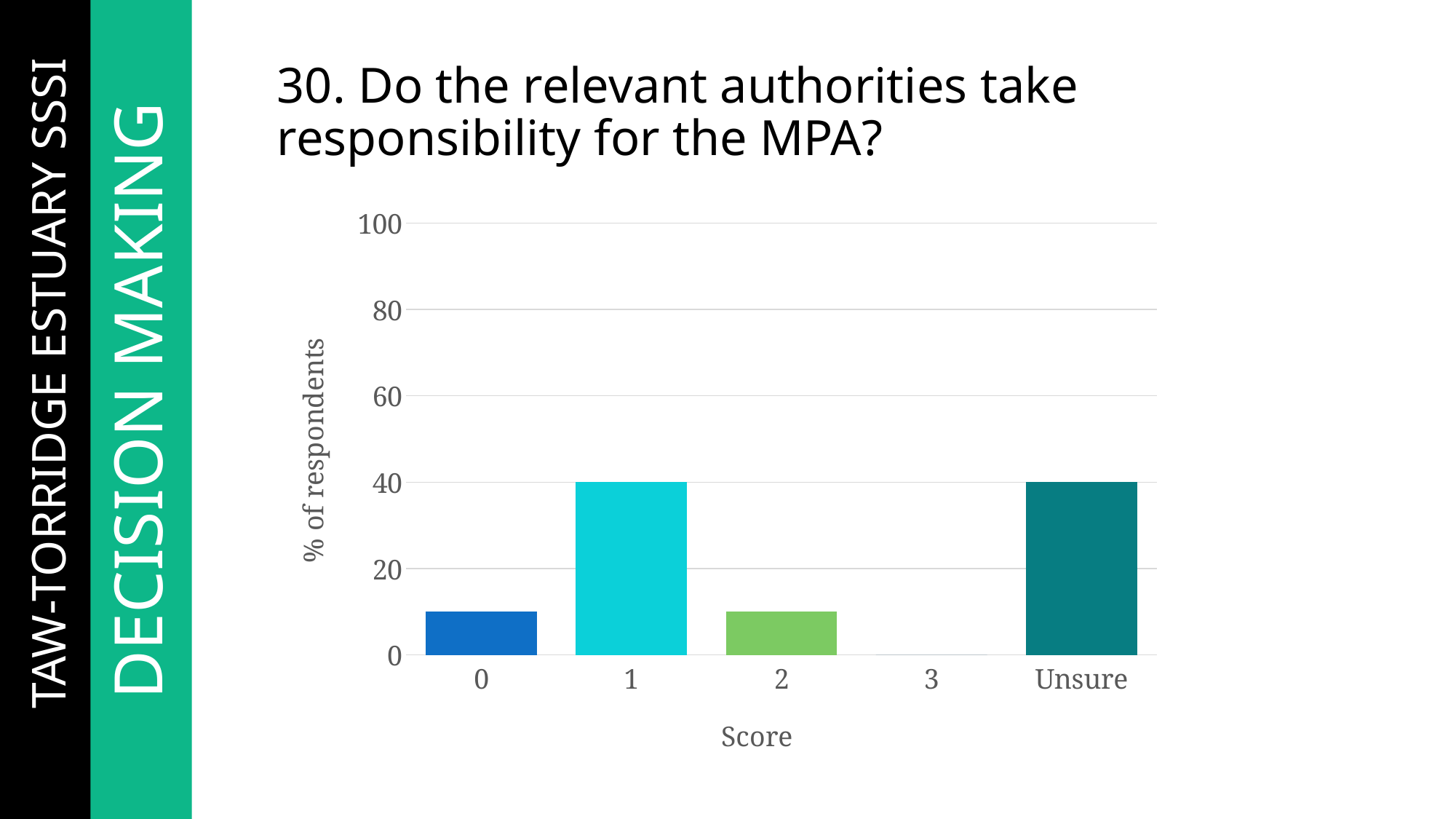
What is the label of the y axis? % of respondents What is the difference in % of respondents between score 1 and score 3? 40 What is the % of respondents for score 1? 40 Which score category has the lowest % of respondents? 3 Is the value for score 0 greater or less than 20? less Which has a higher % of respondents, score 2 or Unsure? Unsure How many score categories are shown on the x axis? 5 Is the value for score 2 greater or less than 20? less What kind of chart is shown on the slide? bar chart What is the % of respondents for score 3? 0 Which has a higher % of respondents, score 0 or score 1? 1 What is the % of respondents for Unsure? 40